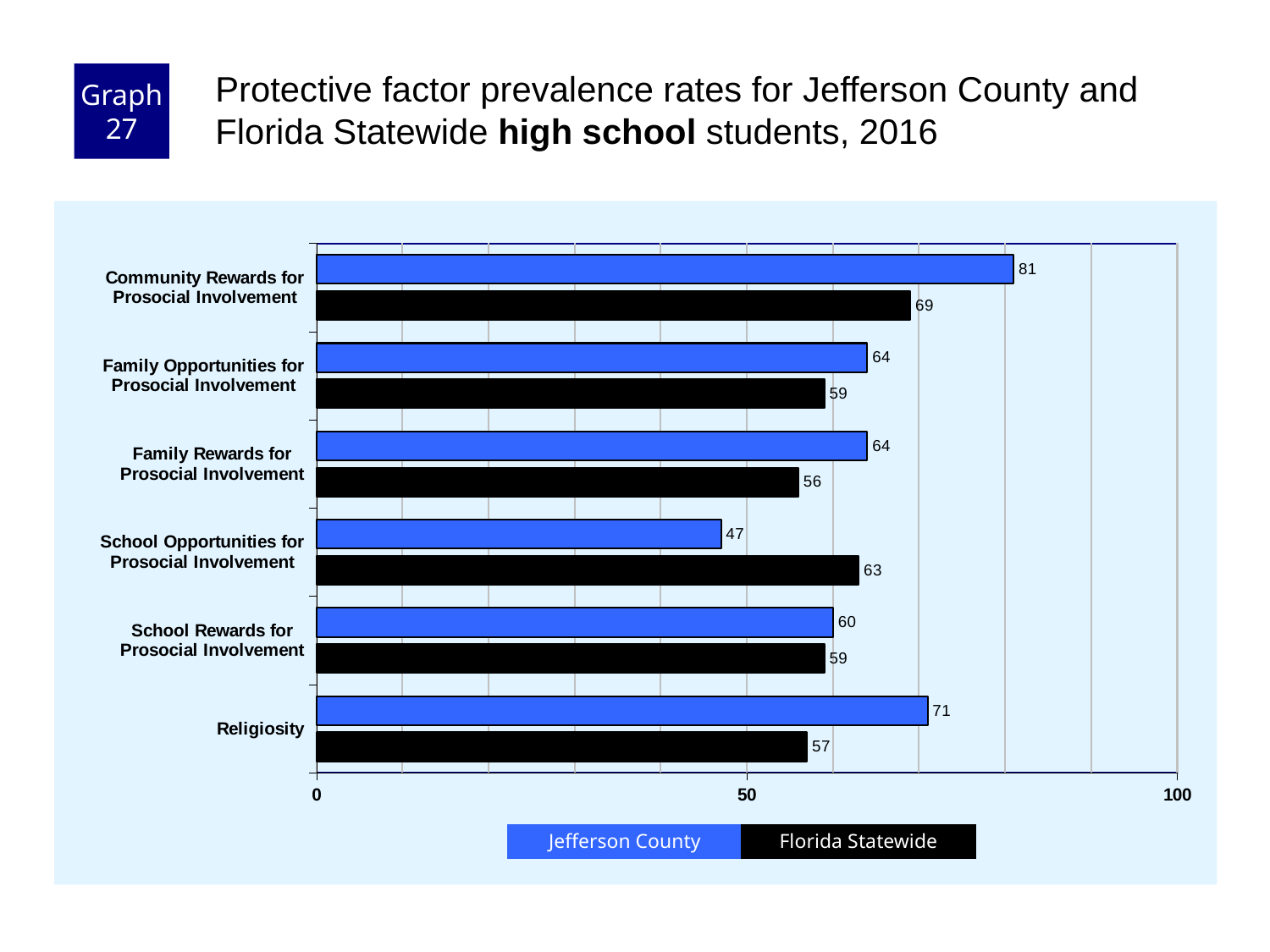
How many series does the legend list? 2 Which category has the lowest Jefferson County value? School Opportunities for Prosocial Involvement Which category has the highest Jefferson County value? Community Rewards for Prosocial Involvement What is the Florida Statewide value for Religiosity? 57 What is the difference between the Jefferson County and Florida Statewide values for Religiosity? 14 What kind of chart is shown on the slide? Bar chart What is the Florida Statewide value for School Opportunities for Prosocial Involvement? 63 Is the Jefferson County value for School Opportunities for Prosocial Involvement greater or less than 50? less Which category has the lowest Florida Statewide value? Family Rewards for Prosocial Involvement How many categories are shown on the chart? 6 What is the Jefferson County value for Community Rewards for Prosocial Involvement? 81 For School Opportunities for Prosocial Involvement, which is larger: Jefferson County or Florida Statewide? Florida Statewide